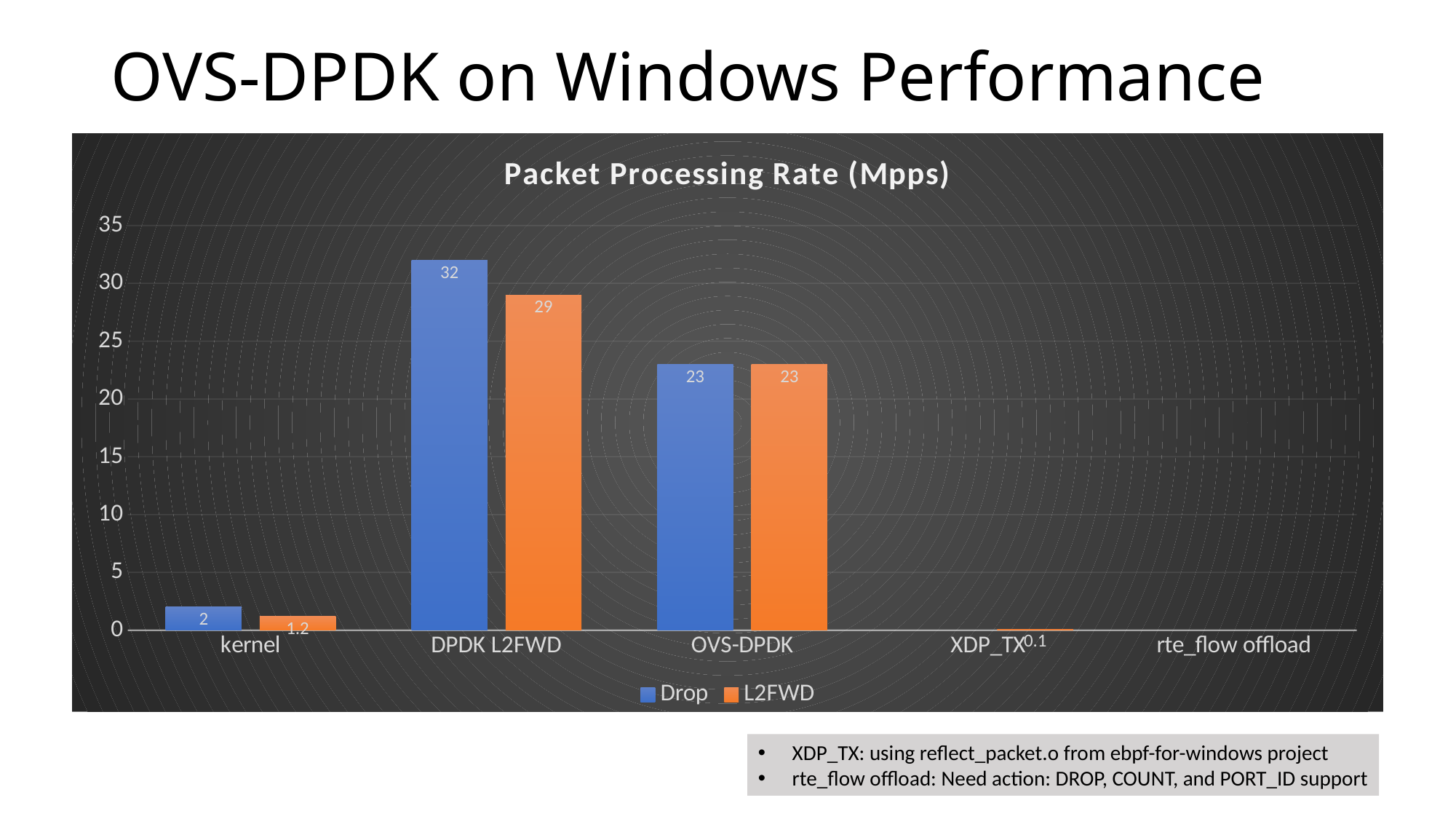
Is the L2FWD value for DPDK L2FWD greater or less than 25? greater How many categories are shown on the x axis? 5 Which category has the lowest L2FWD value among those with a labelled bar? XDP_TX What type of chart is shown? bar chart What is the L2FWD value for XDP_TX? 0.1 Which is larger, the Drop value for DPDK L2FWD or the Drop value for OVS-DPDK? DPDK L2FWD Which category has the highest Drop value? DPDK L2FWD What is the L2FWD value for OVS-DPDK? 23 What is the Drop value for DPDK L2FWD? 32 What is the difference between the Drop and L2FWD values for DPDK L2FWD? 3 What is the L2FWD value for kernel? 1.2 How many series does the legend list? 2